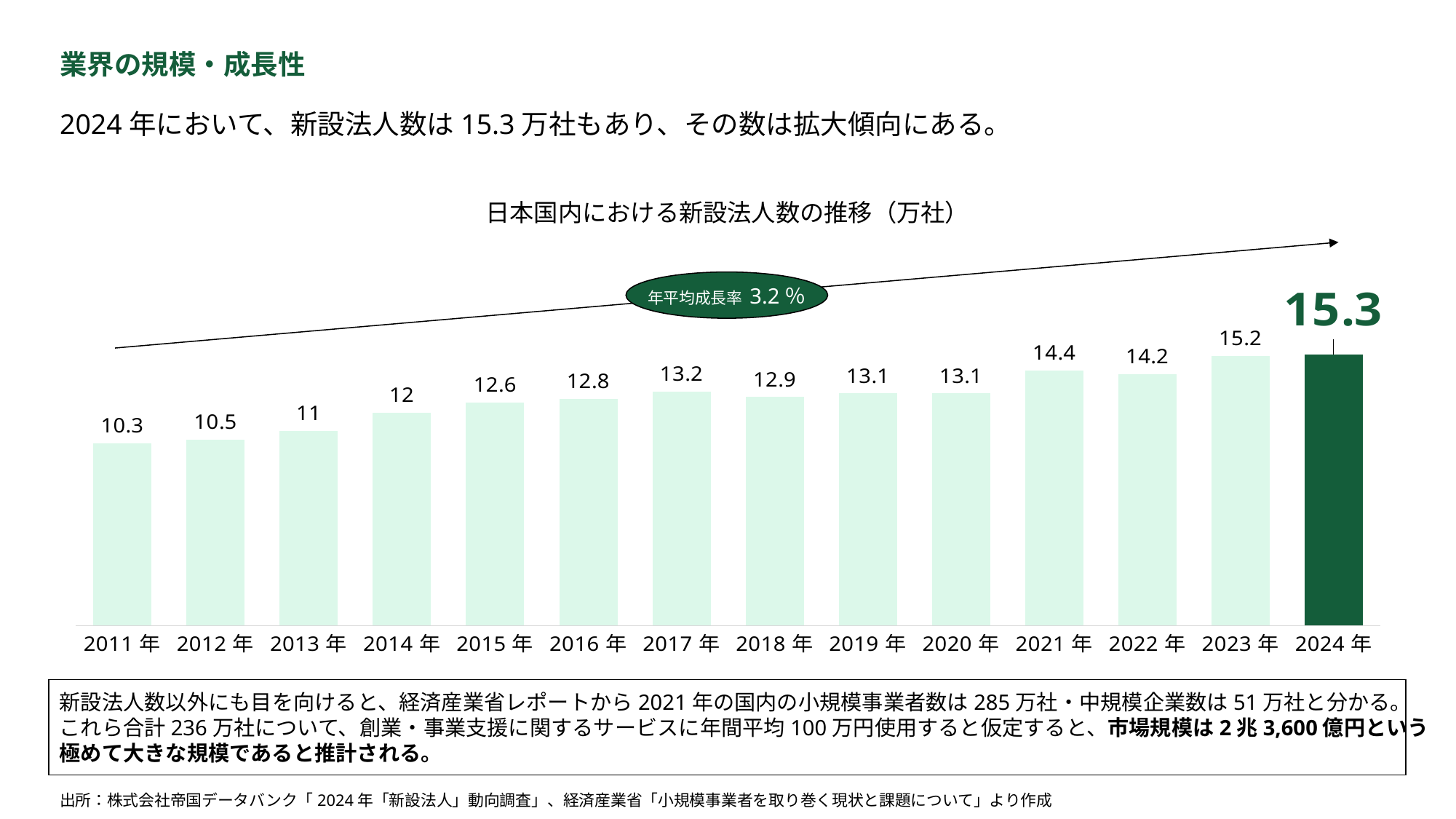
How many years are shown in the chart? 14 Which year has the lowest value in the chart? 2011年 What is the difference between the values for 2021年 and 2022年? 0.2 What is the value for 2011年 in the chart? 10.3 What is the difference between the values for 2024年 and 2011年? 5 What annual average growth rate is shown in the oval label on the chart? 3.2% What is the value for 2017年 in the chart? 13.2 What kind of chart is shown on the slide? bar chart What is the value for 2024年 in the chart? 15.3 Do the values generally rise or fall from 2011年 to 2024年? rise Which year has the highest value in the chart? 2024年 Which is larger, the value for 2022年 or the value for 2023年? 2023年